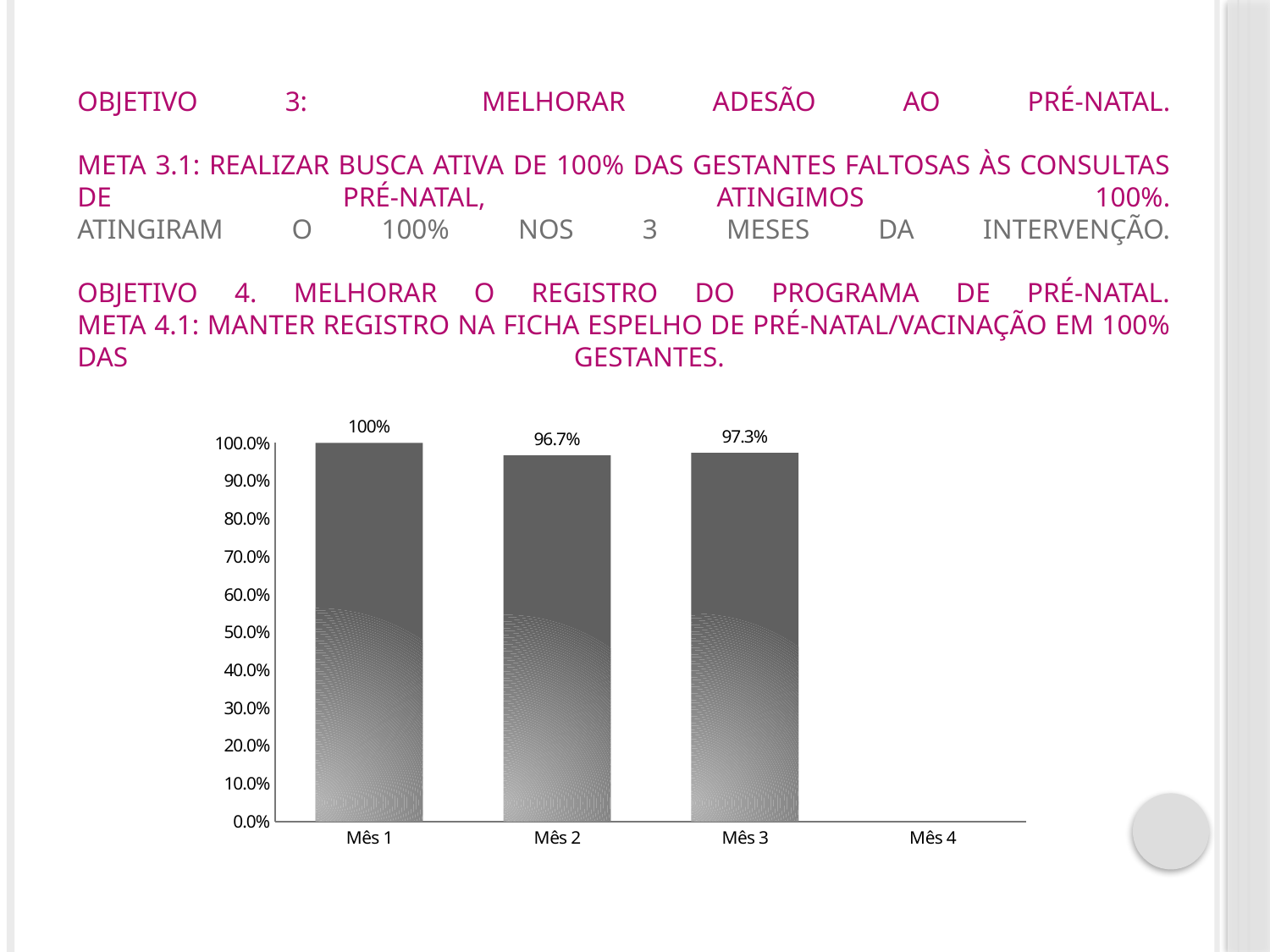
Which month has the highest value? Mês 1 Which month with a plotted bar has the lowest value? Mês 2 Which is larger, the value for Mês 2 or the value for Mês 3? Mês 3 What is the difference between the values for Mês 1 and Mês 2? 3.3% What is the value shown for Mês 2? 96.7% What is the value shown for Mês 1? 100% What kind of chart is shown on the slide? bar chart What is the difference between the values for Mês 3 and Mês 2? 0.6% How many bars are plotted on the chart? 3 Is the value for Mês 2 greater or less than 90.0%? greater Does the value rise or fall from Mês 1 to Mês 2? fall What is the value shown for Mês 3? 97.3%